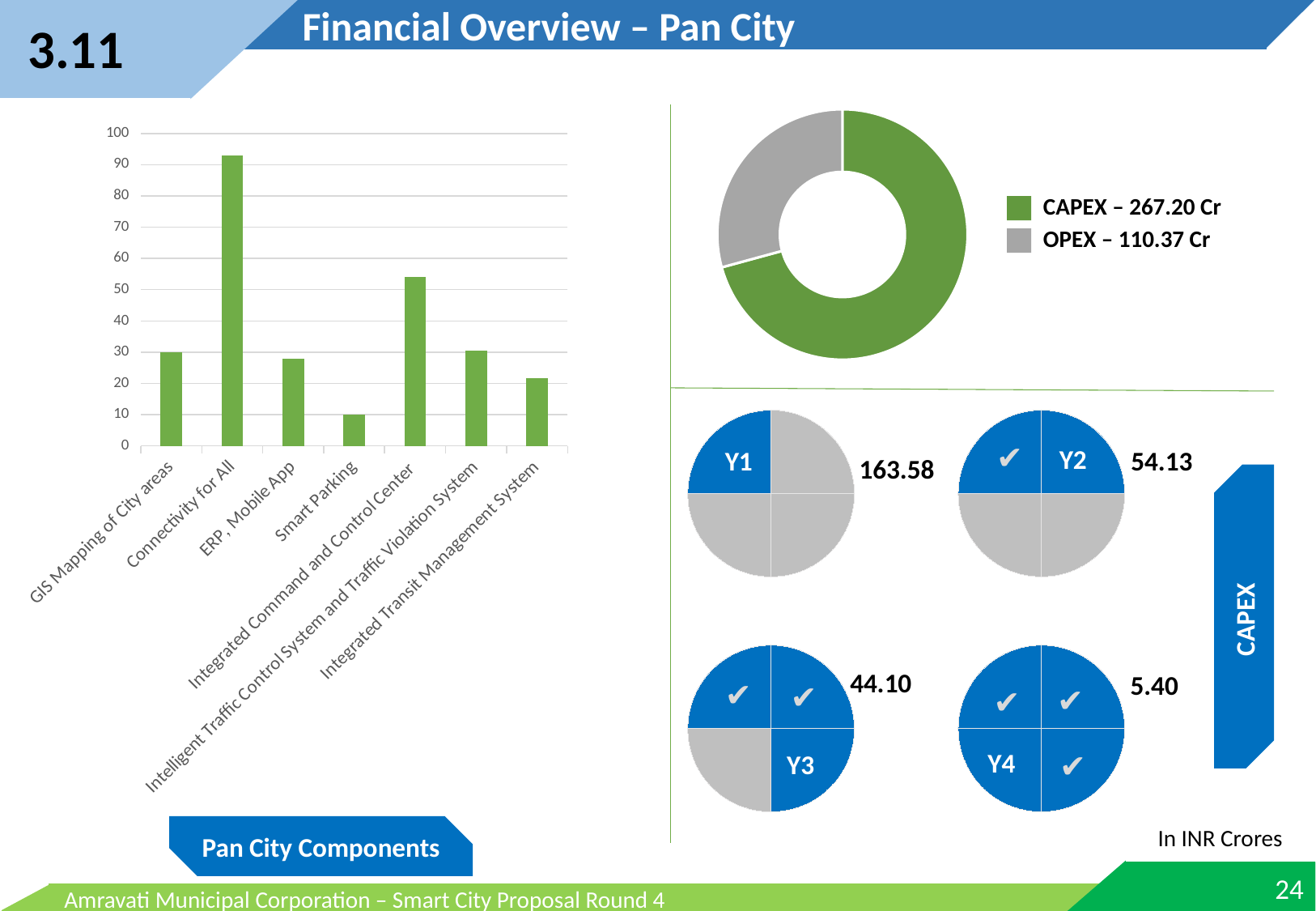
What kind of chart is the Pan City Components chart on the left of the slide? bar chart In the CAPEX year-wise pies, which year has the lowest value? Y4 In the Pan City Components bar chart, which component has the lowest value? Smart Parking How many components are plotted in the Pan City Components bar chart? 7 In the Pan City Components bar chart, which component has the highest value? Connectivity for All In the Pan City Components bar chart, which is larger: Integrated Command and Control Center or ERP, Mobile App? Integrated Command and Control Center In the Pan City Components bar chart, is the value for Connectivity for All greater or less than 80? greater In the CAPEX year-wise pies, what is the value for Y1? 163.58 In the CAPEX/OPEX donut chart, what is the difference between CAPEX and OPEX? 156.83 Cr In the CAPEX/OPEX donut chart, what is the OPEX value? 110.37 Cr In the CAPEX/OPEX donut chart, what is the CAPEX value? 267.20 Cr In the Pan City Components bar chart, is the value for Smart Parking greater or less than 20? less